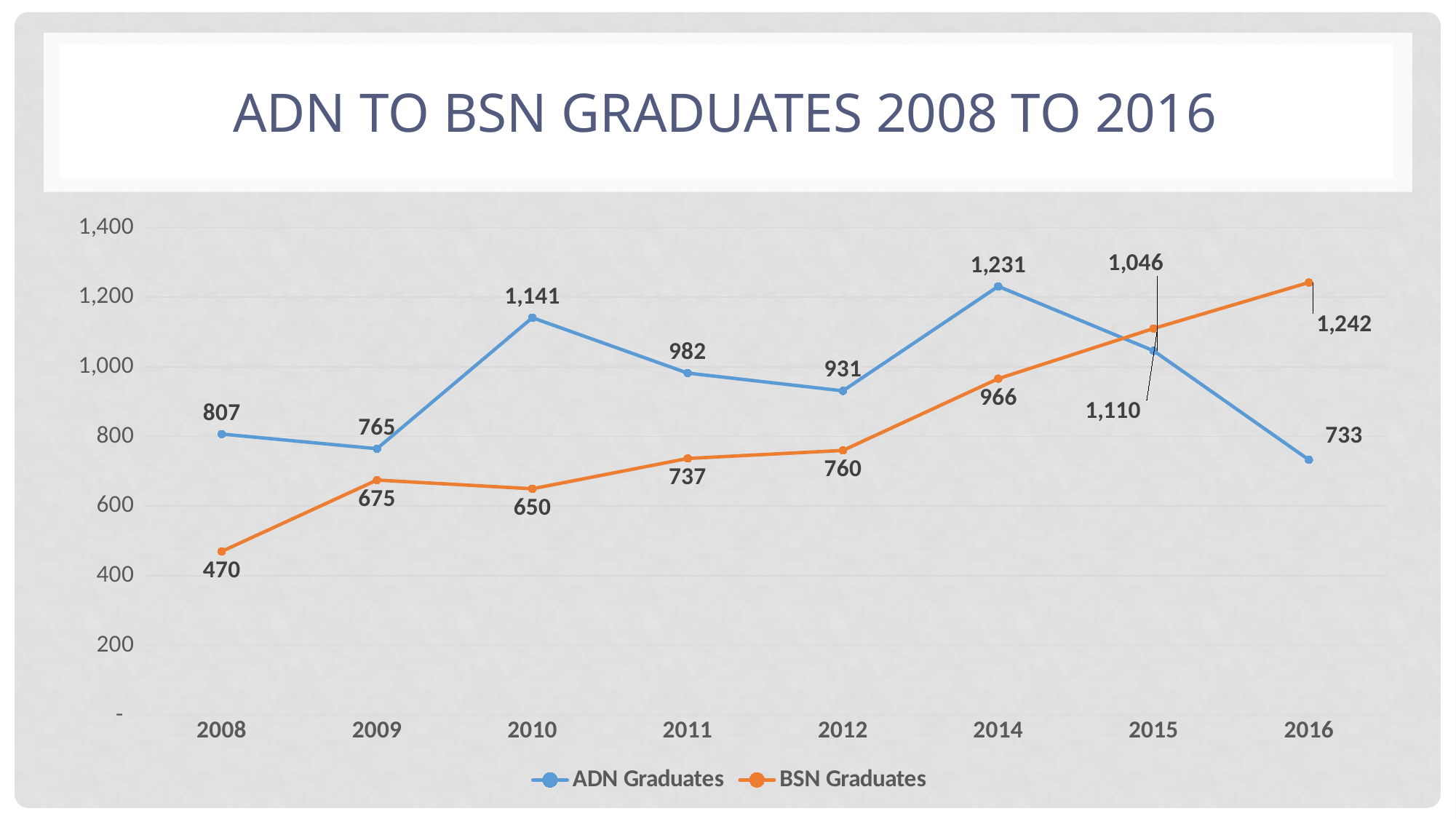
What kind of chart is shown on the slide? line chart How many years are shown on the x axis? 8 In 2012, which series has the larger value, ADN Graduates or BSN Graduates? ADN Graduates What is the value for ADN Graduates in 2010? 1,141 In which year is the BSN Graduates value lowest? 2008 Is the value for BSN Graduates in 2014 greater or less than 800? greater What is the value for BSN Graduates in 2015? 1,110 In which year is the ADN Graduates value highest? 2014 Do the BSN Graduates values rise or fall from 2012 to 2016? rise How many series does the legend list? 2 What is the value for BSN Graduates in 2008? 470 What is the difference between BSN Graduates and ADN Graduates in 2016? 509